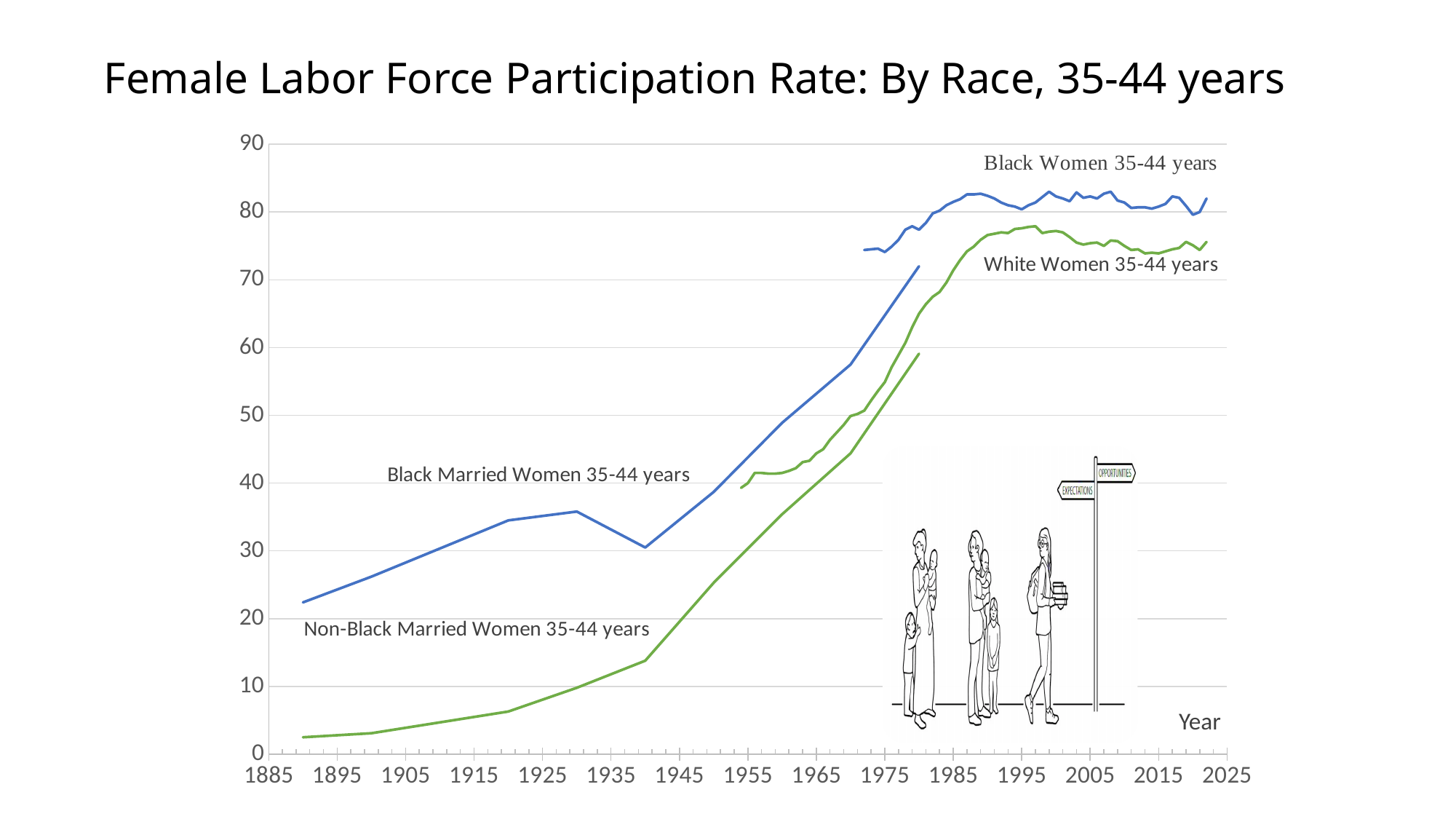
What is the label on the x axis of the chart? Year Is the value for Black Married Women 35-44 years in 1890 greater or less than 20? greater In 1920, which series has the higher value: Black Married Women 35-44 years or Non-Black Married Women 35-44 years? Black Married Women 35-44 years What kind of chart is shown on the slide? line chart Is the value for Black Married Women 35-44 years in 1980 greater or less than 70? greater What is the title of the chart? Female Labor Force Participation Rate: By Race, 35-44 years Is the value for White Women 35-44 years in 2000 greater or less than 80? less How many series are labeled on the chart? 4 Does the Non-Black Married Women 35-44 years line rise or fall from 1890 to 1980? rise In 2000, which series has the higher value: Black Women 35-44 years or White Women 35-44 years? Black Women 35-44 years